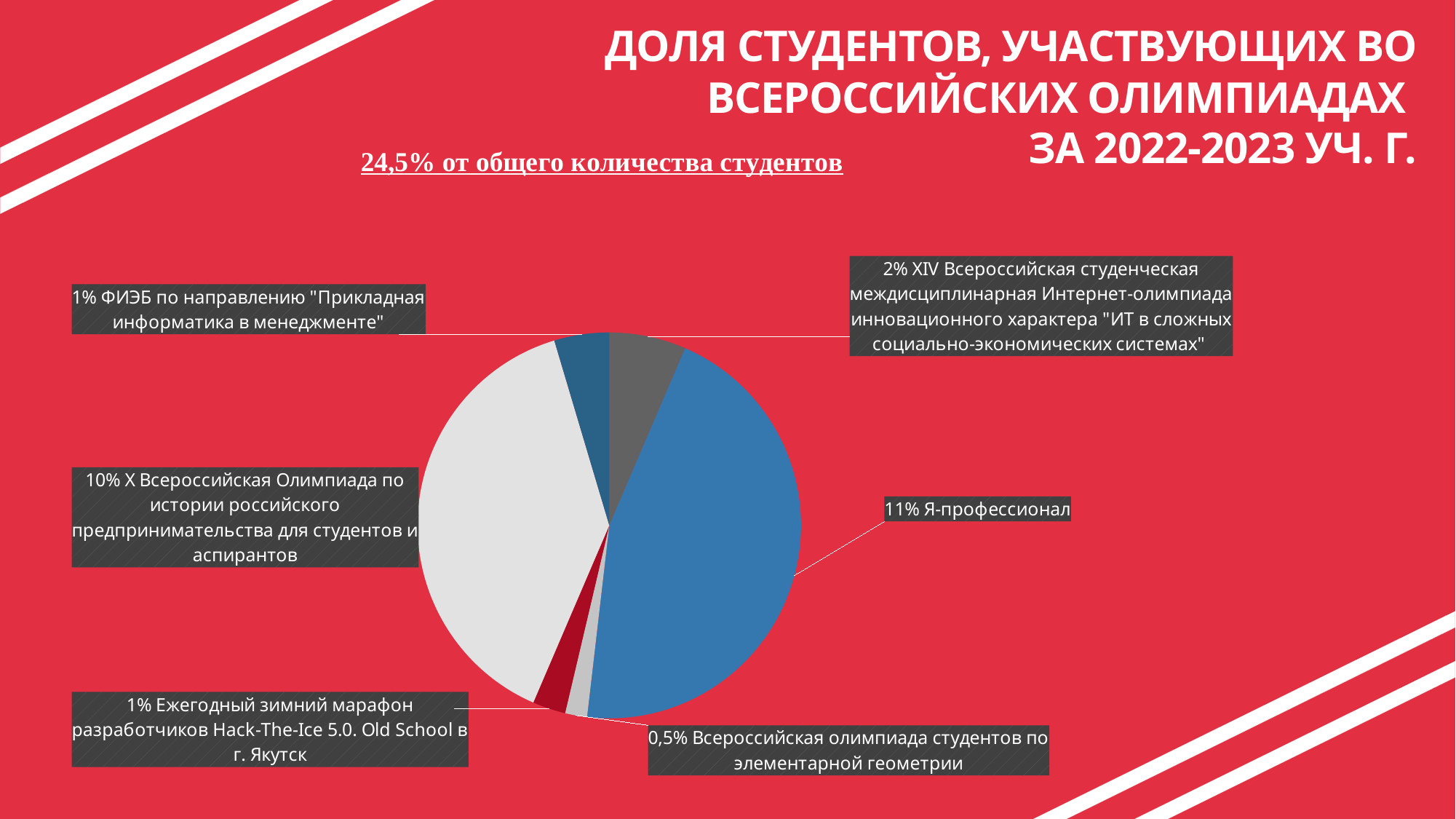
What share is labelled for Я-профессионал? 11% What share is labelled for the Ежегодный зимний марафон разработчиков Hack-The-Ice 5.0? 1% Which is larger: the share for the XIV Всероссийская студенческая Интернет-олимпиада or the share for ФИЭБ? XIV Всероссийская студенческая Интернет-олимпиада What kind of chart is shown on the slide? pie chart What share is labelled for the XIV Всероссийская студенческая междисциплинарная Интернет-олимпиада? 2% How many labelled slices does the pie chart have? 6 Which labelled slice has the smallest share? Всероссийская олимпиада студентов по элементарной геометрии What share is labelled for the Всероссийская олимпиада студентов по элементарной геометрии? 0,5% What share is labelled for the X Всероссийская Олимпиада по истории российского предпринимательства? 10% What is the difference between the shares for Я-профессионал and the X Всероссийская Олимпиада по истории российского предпринимательства? 1% What total share of students is stated in the subtitle above the chart? 24,5% Which labelled slice has the largest share? Я-профессионал